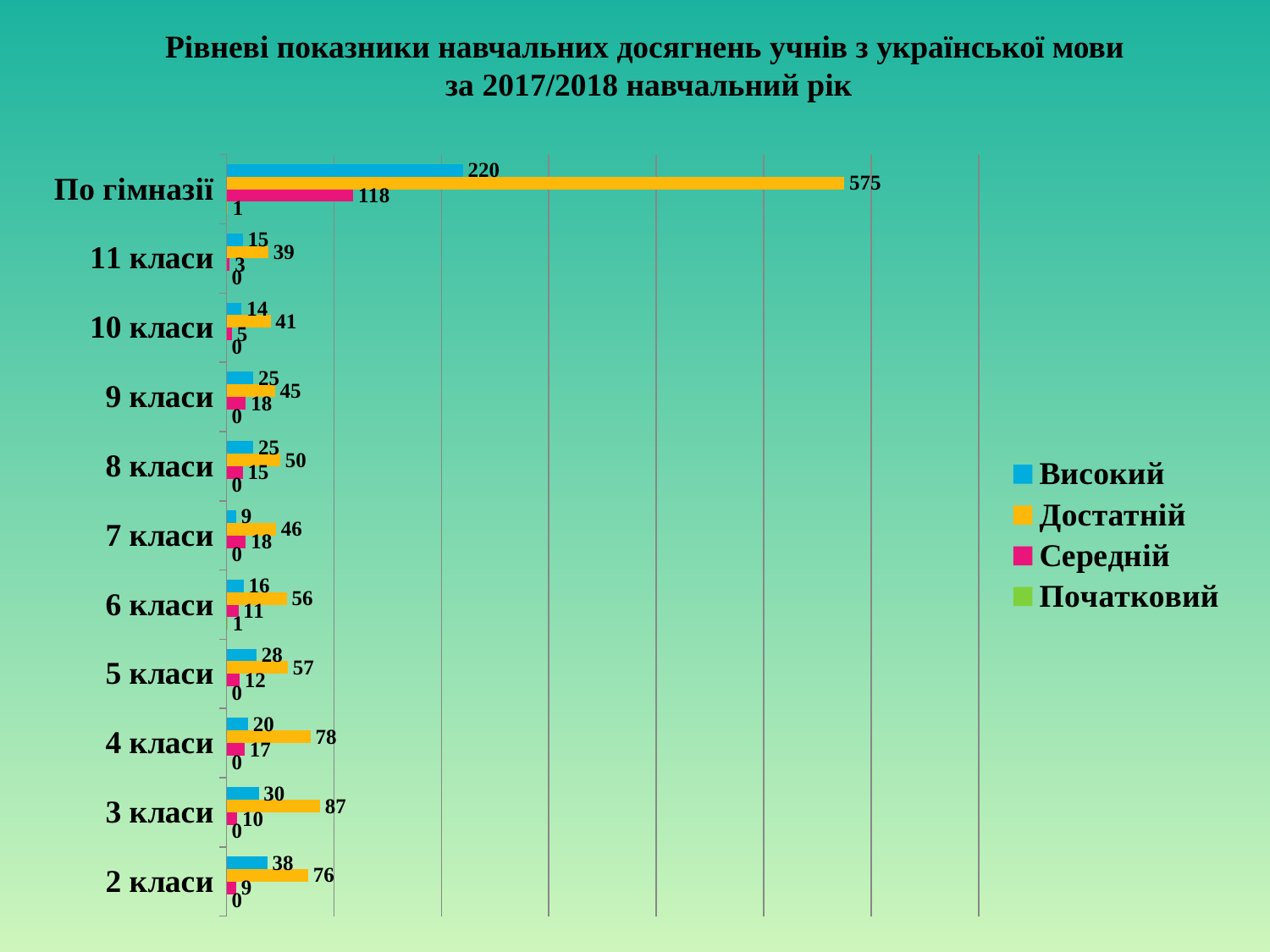
Among the class groups (excluding По гімназії), which category has the highest Достатній value? 3 класи Among the class groups (excluding По гімназії), which category has the lowest Високий value? 7 класи What is the difference between the Достатній values for 4 класи and 5 класи? 21 Which is larger: the Високий value for 3 класи or for 5 класи? 3 класи What is the value of Високий for 2 класи? 38 What is the value of Середній for 9 класи? 18 How many categories are shown on the vertical axis? 11 Which colour represents the Середній series in the legend? Pink What kind of chart is shown on the slide? Bar chart What is the value of Достатній for По гімназії? 575 How many series does the legend list? 4 What is the value of Початковий for 6 класи? 1